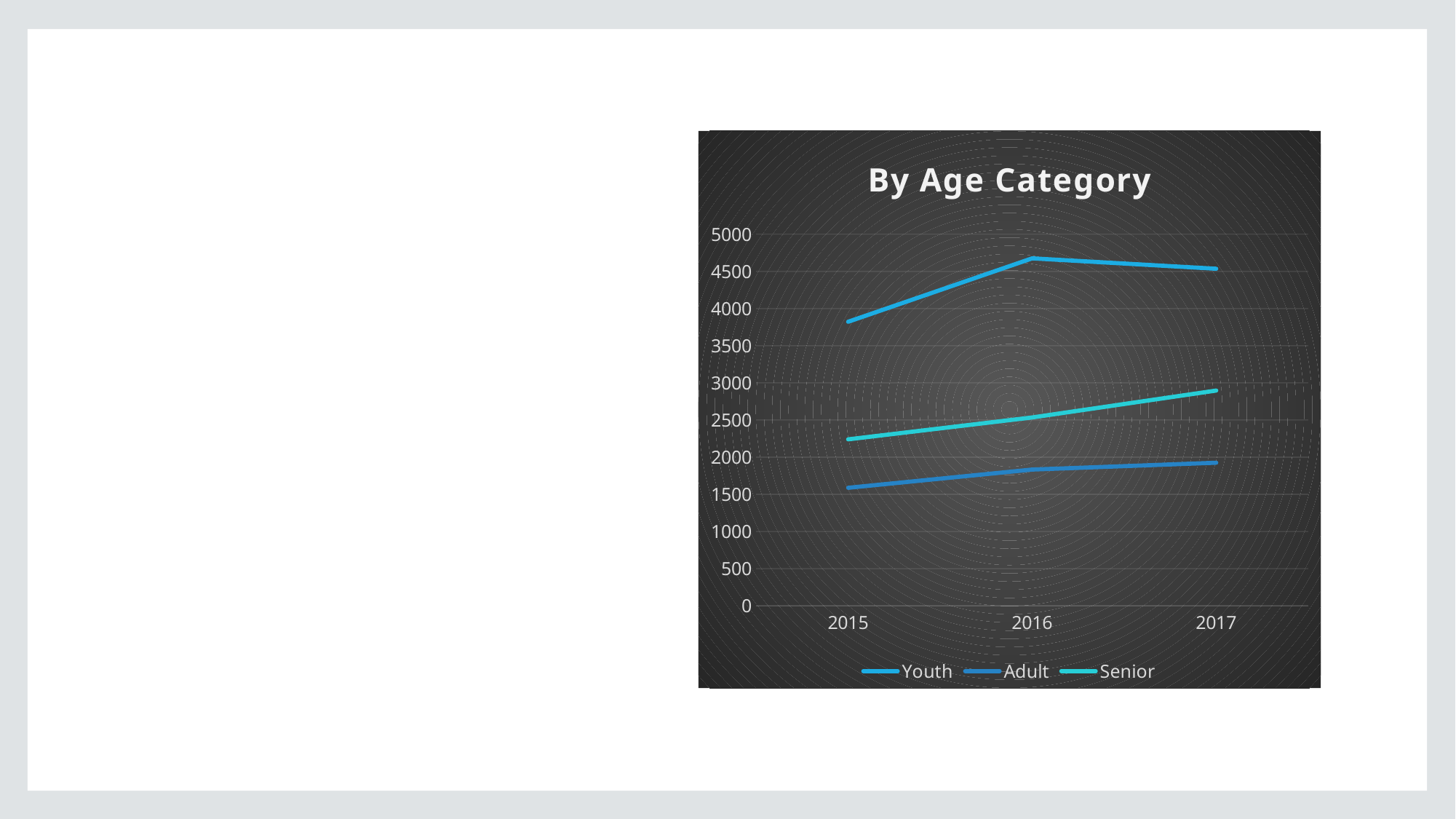
Is the Youth value for 2015 greater or less than 3500? greater What kind of chart is shown on the slide? line chart Which series has the highest values across all years? Youth Is the Adult value for 2017 greater or less than 2000? less Is the Senior value for 2017 greater or less than 3000? less Which is larger in 2016, the Senior value or the Adult value? Senior Which series has the lowest values across all years? Adult How many series does the legend list? 3 What is the title of the chart? By Age Category How many years are shown on the x axis? 3 Does the Senior series rise or fall from 2015 to 2017? rise